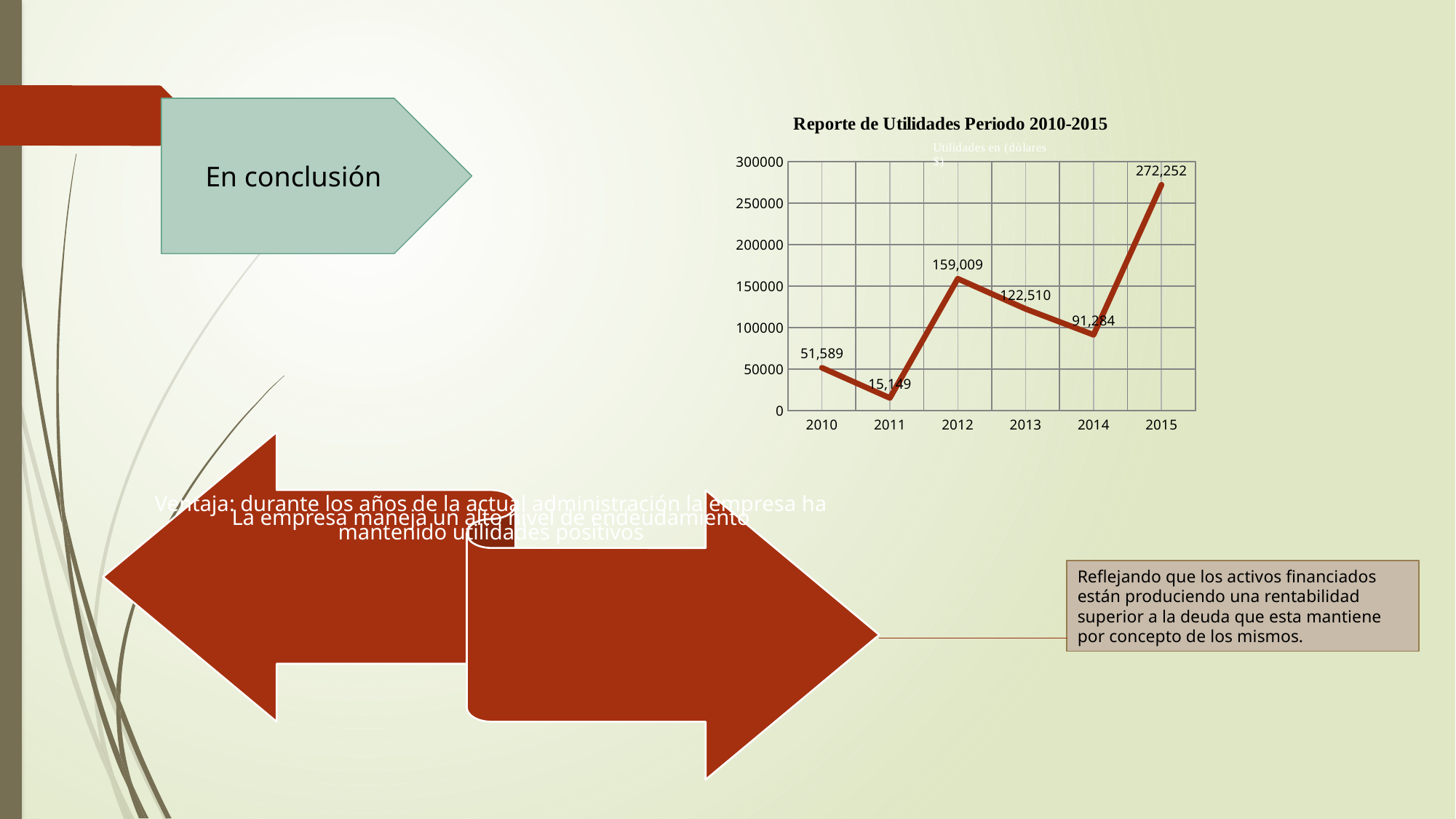
Which year has the lowest value? 2011 What is the title of the chart? Reporte de Utilidades Periodo 2010-2015 What is the difference between the values for 2013 and 2014? 31,226 What is the value for 2013? 122,510 What is the value for 2014? 91,284 What type of chart is shown on the slide? line chart Which is larger, the value for 2012 or the value for 2013? 2012 Which year has the highest value? 2015 What is the value for 2010? 51,589 What is the difference between the values for 2015 and 2012? 113,243 How many years are plotted on the chart? 6 Did the value rise or fall from 2014 to 2015? rise